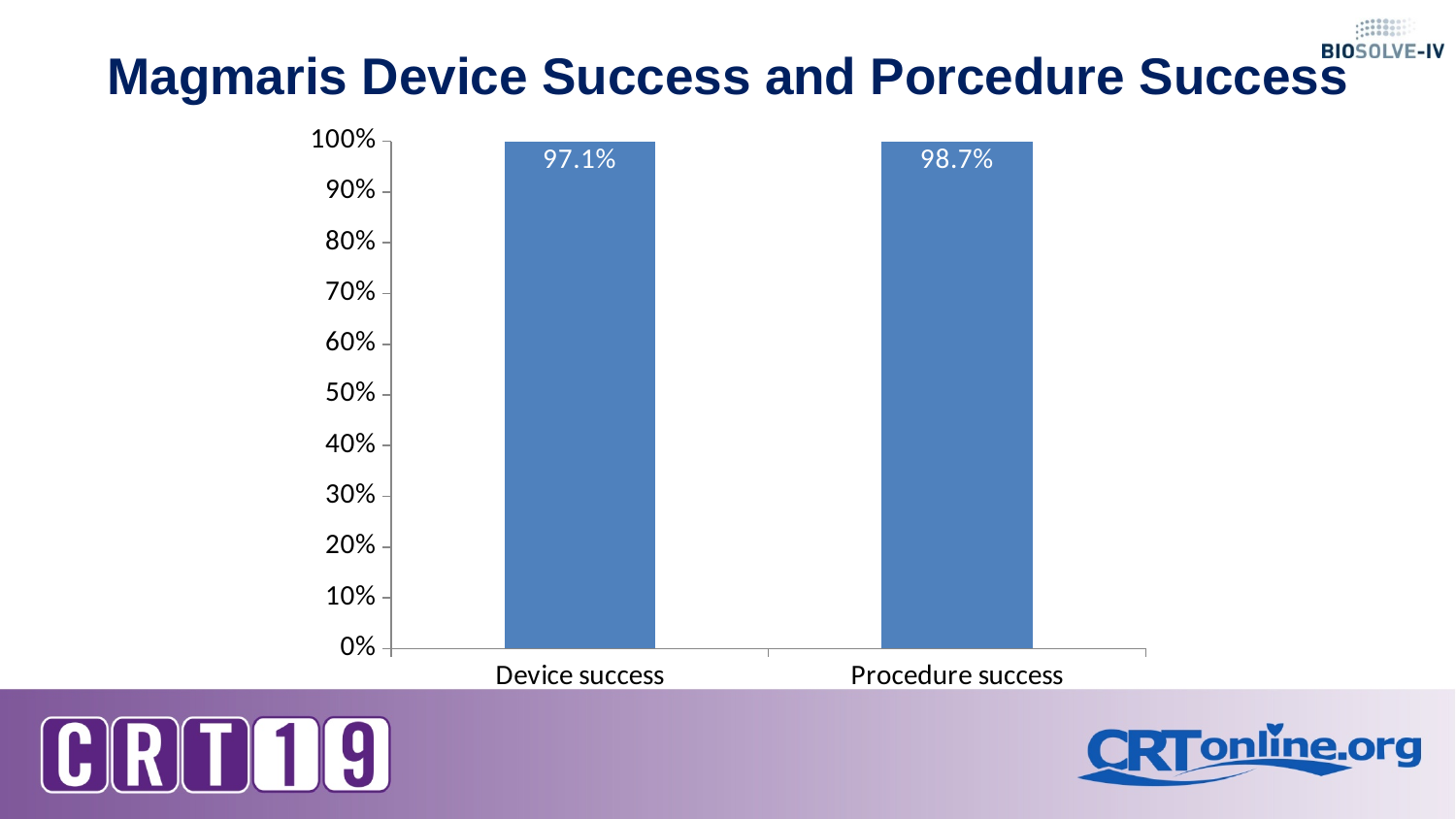
What is the title of the slide? Magmaris Device Success and Porcedure Success Which category has the lower value? Device success What is the maximum value shown on the y axis? 100% What is the difference between Procedure success and Device success? 1.6% What is the value for Procedure success? 98.7% How many categories are shown on the chart? 2 Which category has the higher value? Procedure success What kind of chart is shown on the slide? Bar chart Is the value for Device success greater or less than 90%? greater What is the value for Device success? 97.1%